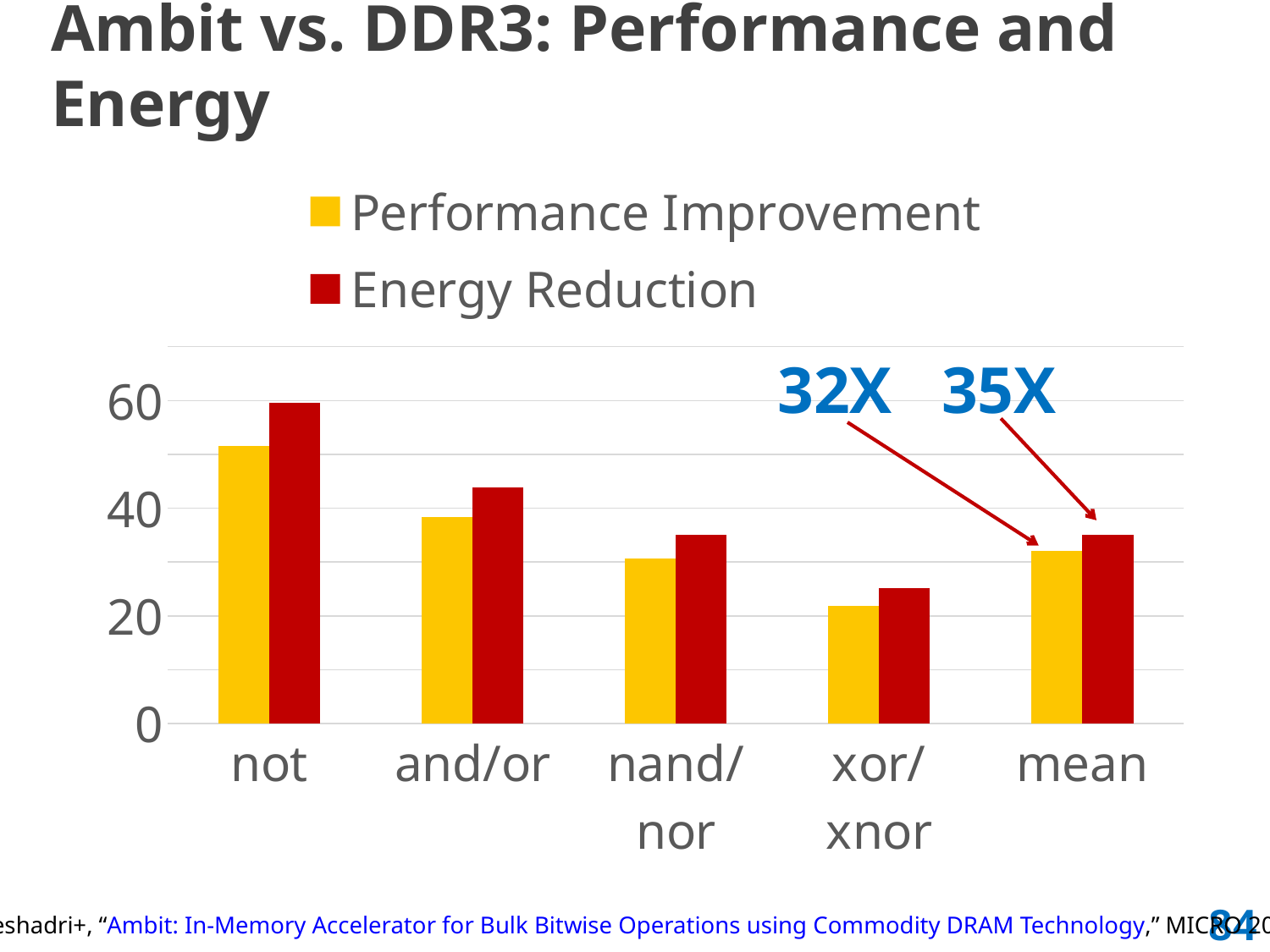
How many series does the legend list? 2 Do the Performance Improvement values rise or fall from not to xor/xnor? fall What kind of chart is shown on the slide? bar chart Which is larger for and/or: Performance Improvement or Energy Reduction? Energy Reduction Which category has the lowest Energy Reduction? xor/xnor What is the Energy Reduction value annotated for the mean category? 35X Which category has the highest Performance Improvement? not How many categories are shown on the x axis? 5 Is the Energy Reduction value for not greater or less than 40? greater What is the Performance Improvement value annotated for the mean category? 32X Which series is shown in red? Energy Reduction Is the Performance Improvement value for xor/xnor greater or less than 40? less